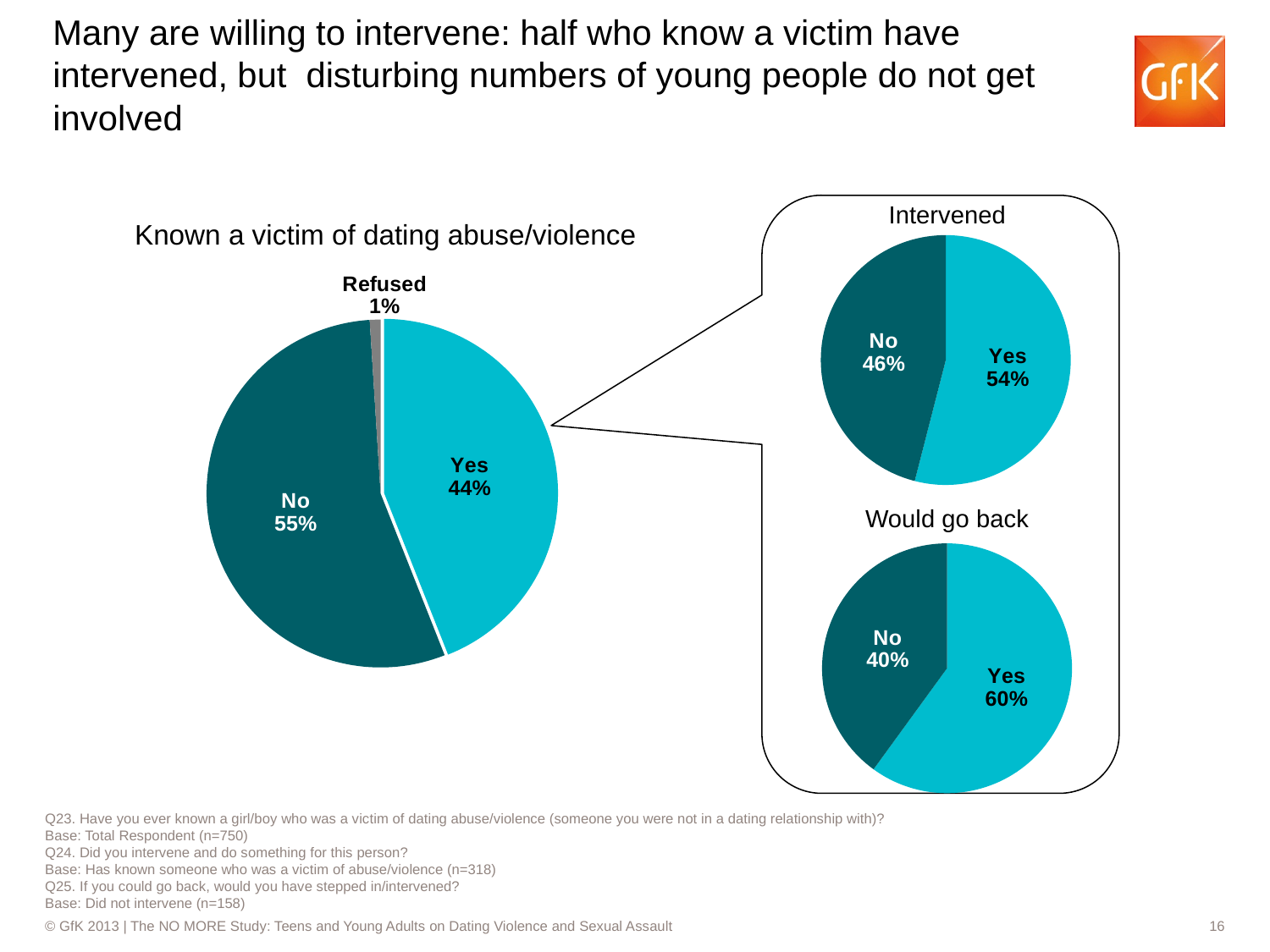
In the 'Would go back' chart, what percentage answered No? 40% In the 'Known a victim of dating abuse/violence' chart, which slice is the smallest? Refused In the 'Intervened' chart, what is the difference between the Yes and No percentages? 8% In the 'Known a victim of dating abuse/violence' chart, which slice is the largest? No In the 'Intervened' chart, what percentage answered Yes? 54% In the 'Known a victim of dating abuse/violence' chart, how many slices does the pie have? 3 What type of chart is the 'Would go back' chart? Pie chart How many pie charts are shown on the slide? 3 In the 'Would go back' chart, which is larger, Yes or No? Yes In the 'Known a victim of dating abuse/violence' chart, what percentage is labelled Refused? 1% In the 'Known a victim of dating abuse/violence' chart, what percentage answered Yes? 44% In the 'Known a victim of dating abuse/violence' chart, what percentage answered No? 55%